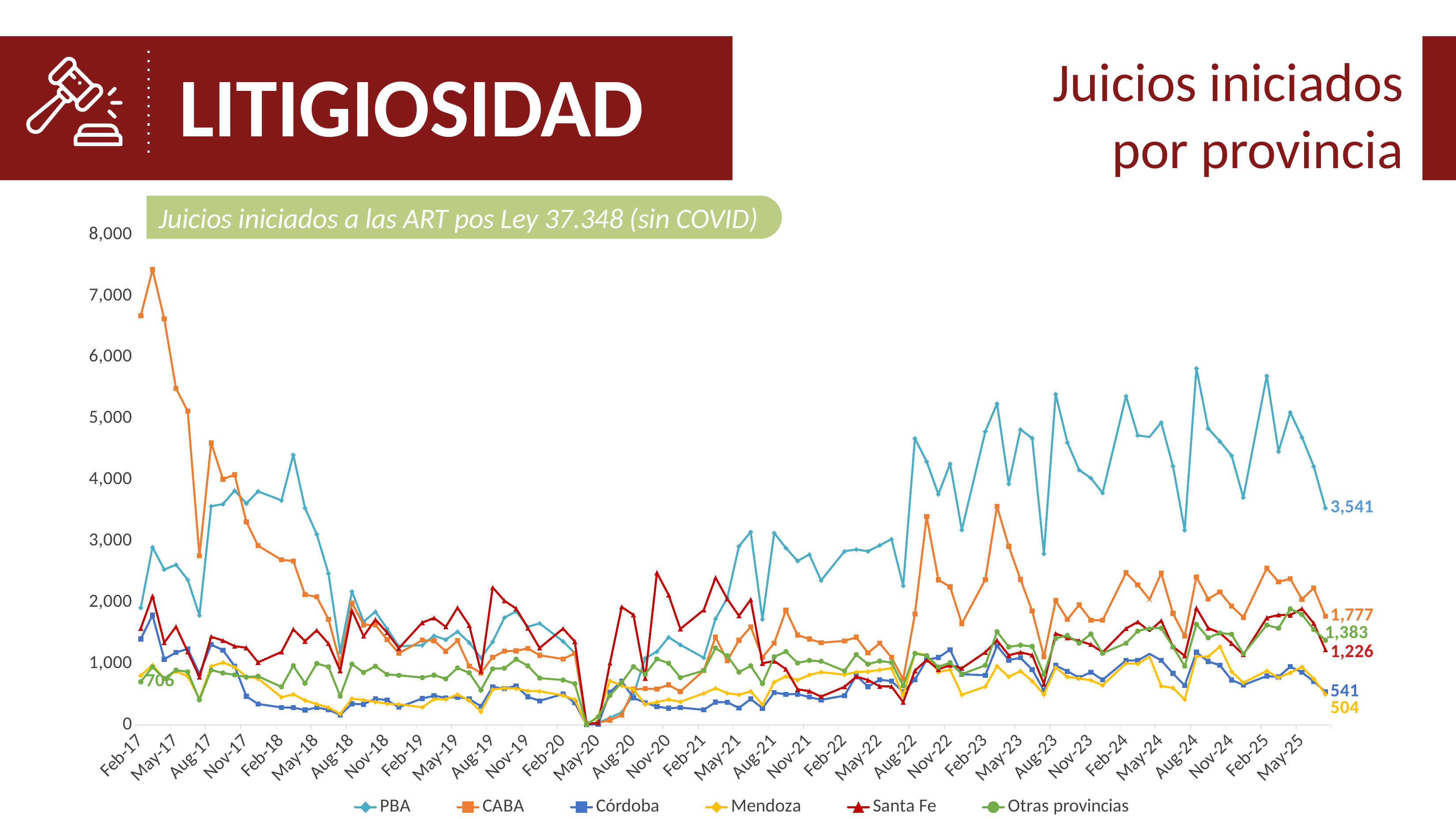
Does the CABA series overall rise or fall from Feb-17 to the end of the series? fall At the end of the series, which is larger: Córdoba or Mendoza? Córdoba What is the difference between the latest labelled values of PBA and CABA? 1,764 What is the latest (rightmost) value labelled for CABA? 1,777 How many series does the legend list? 6 What is the latest (rightmost) value labelled for Córdoba? 541 What kind of chart is shown on the slide? line chart What is the latest (rightmost) value labelled for Mendoza? 504 What value is labelled for Otras provincias at the start of the series (Feb-17)? 706 Is the value for CABA at Feb-17 greater or less than 6,000? greater Which series has the highest value at the end of the series? PBA What is the latest (rightmost) value labelled for PBA? 3,541